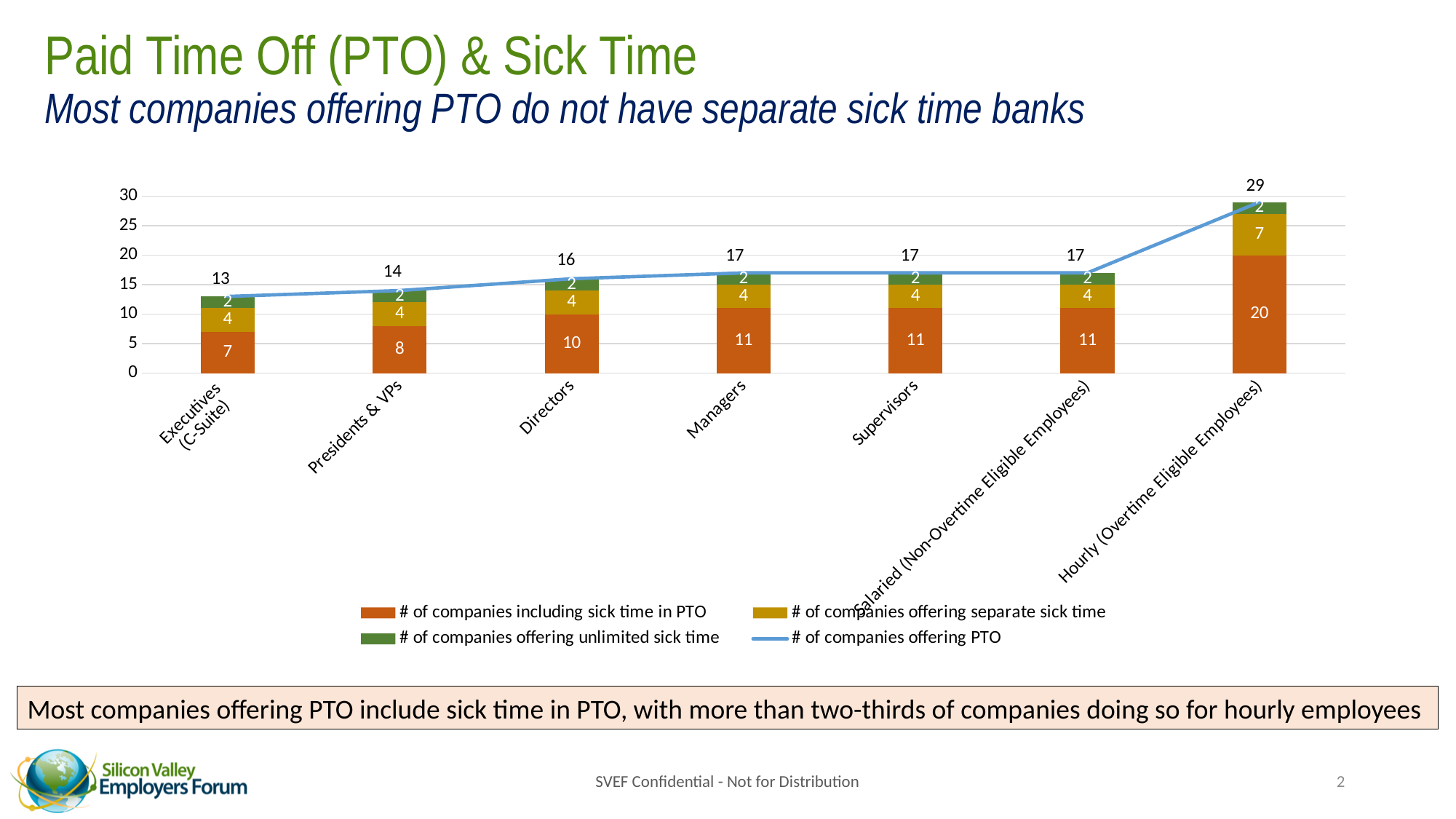
What is the total of the stacked bar for Supervisors? 17 Which is larger: the number of companies including sick time in PTO for Directors or for Presidents & VPs? Directors What is the value of the '# of companies offering PTO' line for Presidents & VPs? 14 What is the difference between the number of companies offering PTO for Hourly (Overtime Eligible Employees) and for Managers? 12 How many companies include sick time in PTO for Hourly (Overtime Eligible Employees)? 20 How many series does the legend list? 4 How many companies offer separate sick time for Directors? 4 What kind of chart is shown on the slide? Stacked bar chart with a line How many companies include sick time in PTO for Executives (C-Suite)? 7 Which employee category has the highest number of companies offering PTO? Hourly (Overtime Eligible Employees) How many employee categories are shown on the x axis? 7 Which employee category has the lowest number of companies including sick time in PTO? Executives (C-Suite)